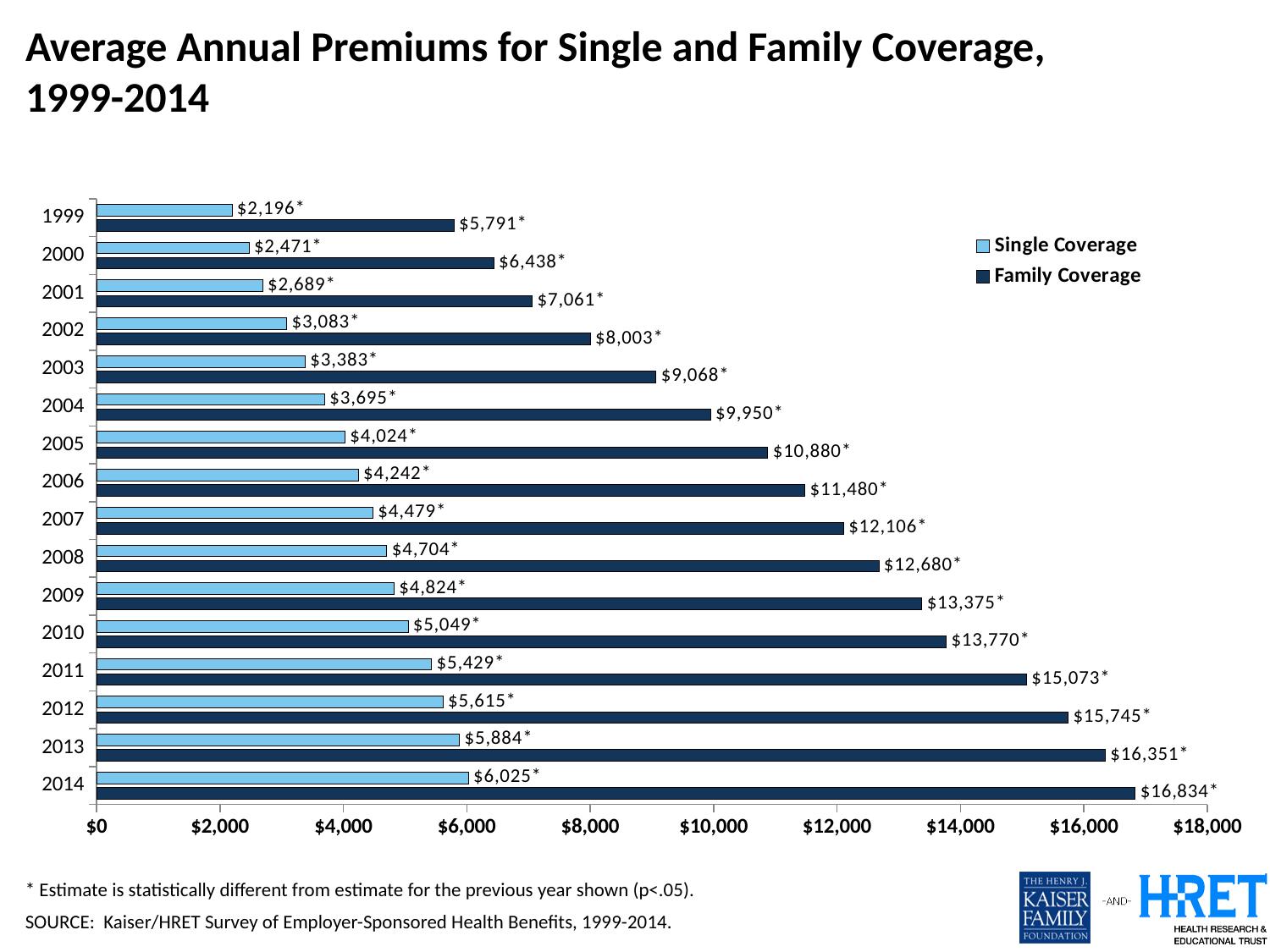
By how much did the Single Coverage premium increase from 1999 to 2014? $3,829 Which year has the lowest Single Coverage premium? 1999 What is the Family Coverage premium for 2005? $10,880 What is the Single Coverage premium for 1999? $2,196 Which year has the highest Family Coverage premium? 2014 What is the difference between the Family Coverage and Single Coverage premiums in 2014? $10,809 What is the Single Coverage premium for 2008? $4,704 What kind of chart is shown on the slide? Bar chart What is the Family Coverage premium for 2014? $16,834 Do the Family Coverage premiums rise or fall from 1999 to 2014? Rise Which is larger, the Family Coverage premium in 2010 or in 2011? 2011 How many series does the legend list? 2